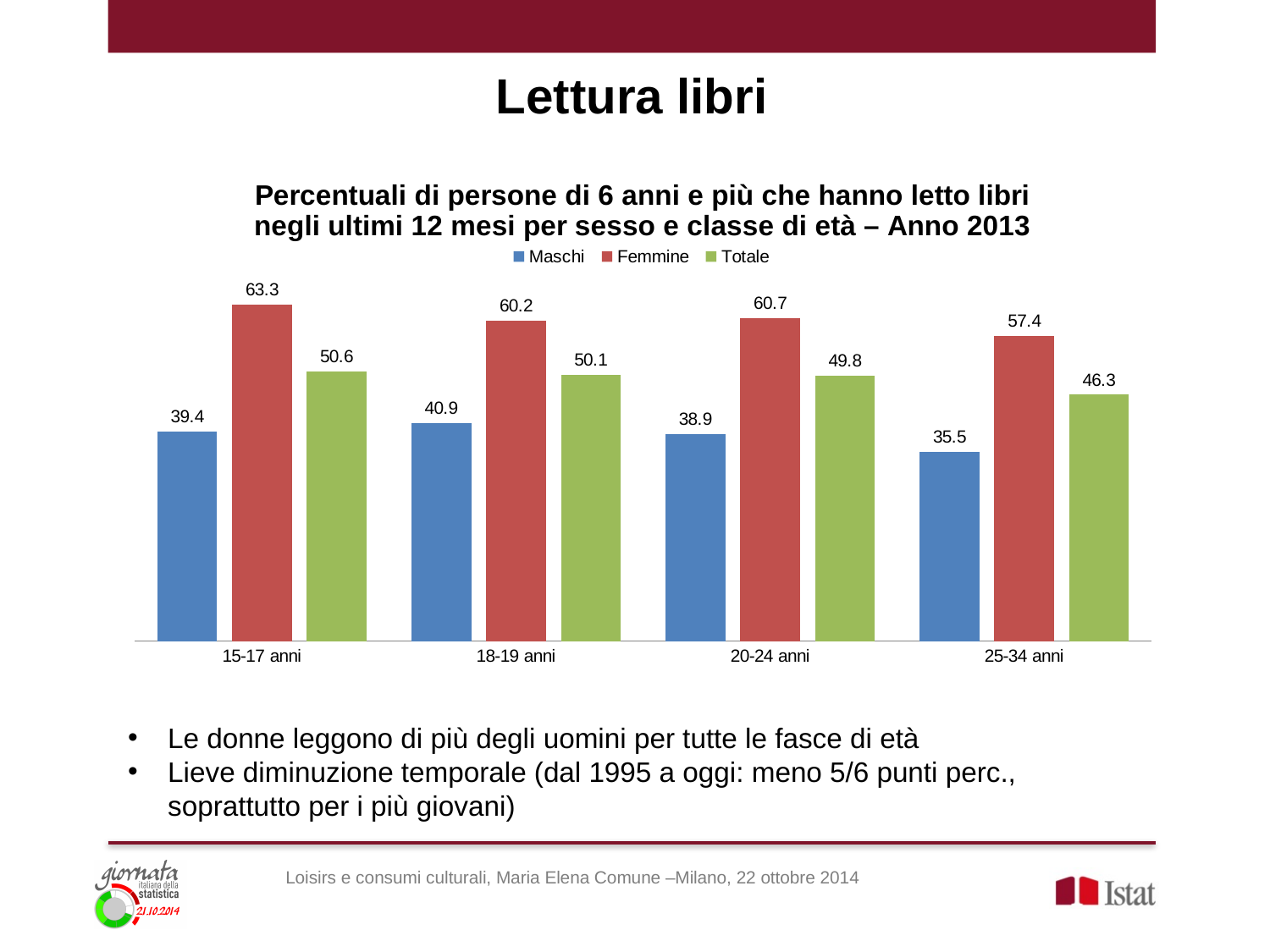
Which age group has the highest value for Femmine? 15-17 anni What kind of chart is shown on the slide? Bar chart Which series is shown in red in the legend? Femmine What is the value for Maschi in the 25-34 anni age group? 35.5 What is the difference between the Femmine and Maschi values in the 20-24 anni age group? 21.8 Does the Totale value rise or fall from 15-17 anni to 25-34 anni? Fall How many series does the legend list? 3 Which is larger in the 18-19 anni age group, the Maschi value or the Totale value? Totale Which age group has the lowest value for Maschi? 25-34 anni What is the value for Totale in the 20-24 anni age group? 49.8 What is the value for Femmine in the 15-17 anni age group? 63.3 How many age groups are shown on the x axis? 4